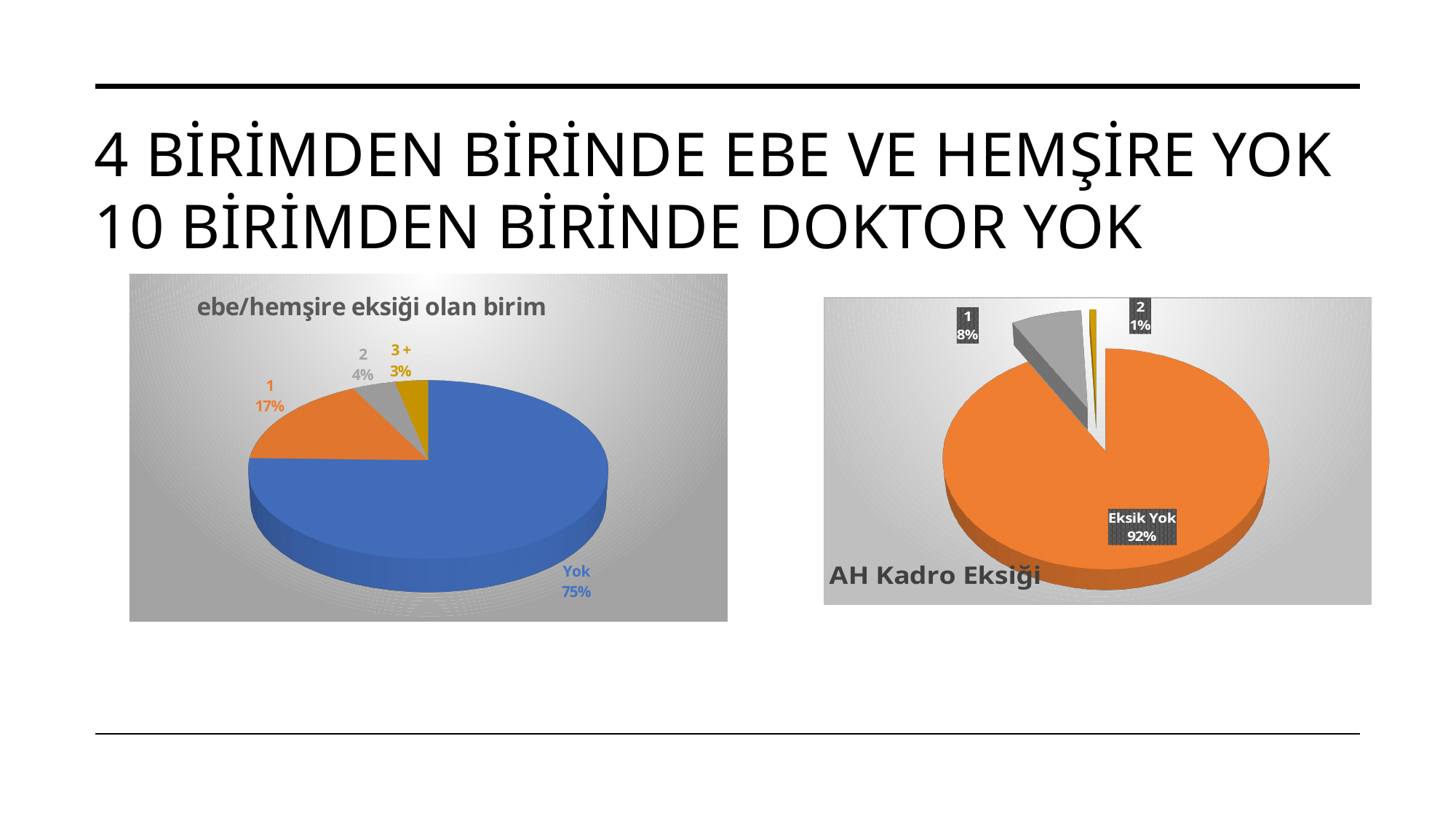
In the chart titled "AH Kadro Eksiği", what share does the "Eksik Yok" slice have? 92% In the chart titled "AH Kadro Eksiği", which category has the largest slice? Eksik Yok In the chart titled "ebe/hemşire eksiği olan birim", what is the value for category "3 +"? 3% What kind of chart is the one on the left of the slide? Pie chart In the chart titled "ebe/hemşire eksiği olan birim", how many slices does the pie have? 4 In the chart titled "AH Kadro Eksiği", which is larger: the slice for "1" or the slice for "2"? 1 In the chart titled "AH Kadro Eksiği", how many slices does the pie have? 3 In the chart titled "AH Kadro Eksiği", what is the value for category "1"? 8% In the chart titled "ebe/hemşire eksiği olan birim", what is the value for category "1"? 17% In the chart titled "ebe/hemşire eksiği olan birim", which category has the smallest slice? 3 + In the chart titled "ebe/hemşire eksiği olan birim", what share does the "Yok" slice have? 75% In the chart titled "ebe/hemşire eksiği olan birim", what is the difference between the "Yok" slice and the "1" slice? 58%